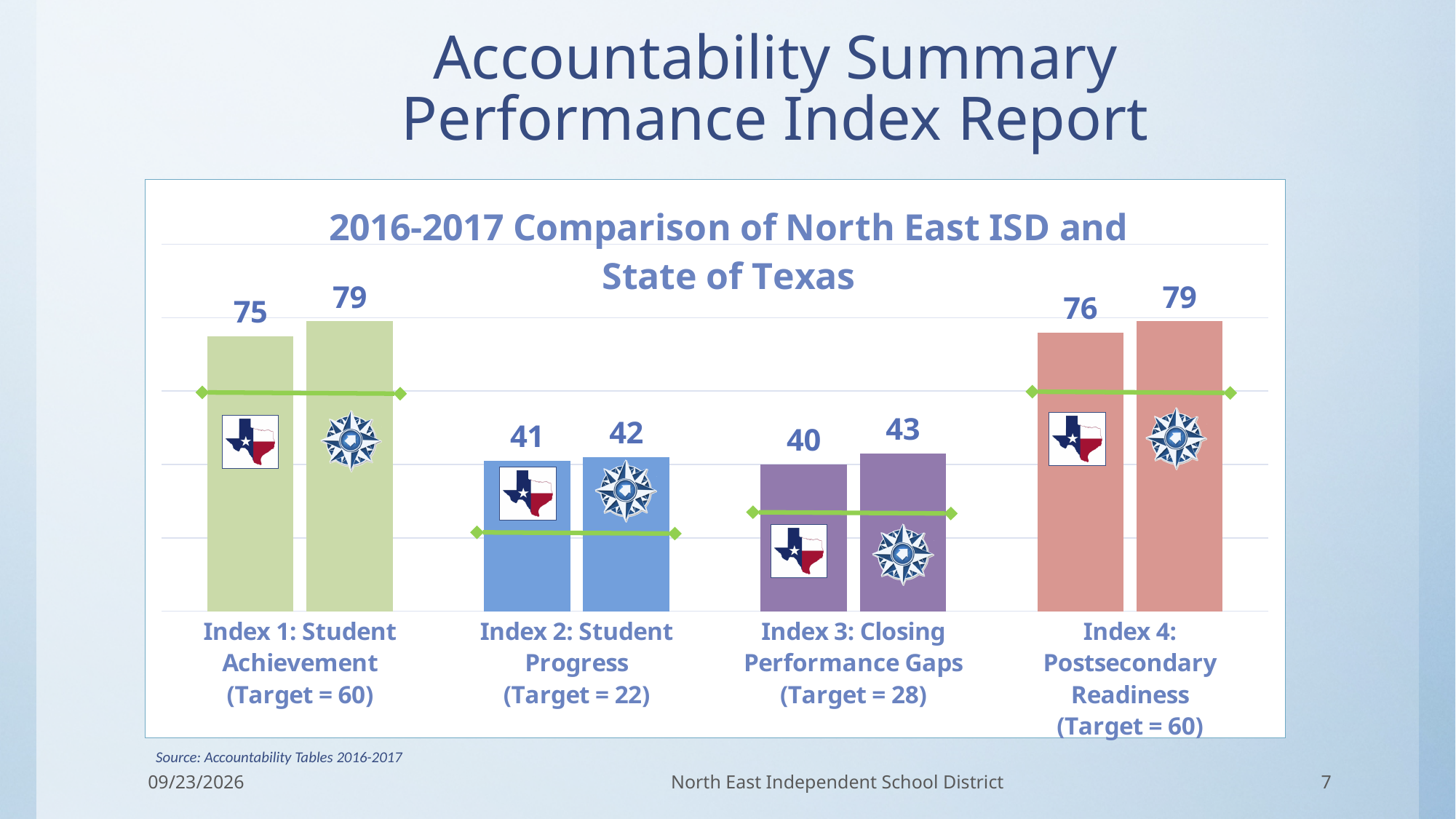
Which index category has the lowest left-bar (Texas icon) value? Index 3: Closing Performance Gaps What is the value of the right bar (compass icon) for Index 3: Closing Performance Gaps? 43 What type of chart is shown on the slide? bar chart What is the difference between the two bars for Index 1: Student Achievement? 4 What is the value of the left bar (Texas icon) for Index 1: Student Achievement? 75 What is the difference between the two bars for Index 3: Closing Performance Gaps? 3 Which is larger: the left bar for Index 2: Student Progress or the left bar for Index 4: Postsecondary Readiness? Index 4: Postsecondary Readiness What is the value of the left bar (Texas icon) for Index 4: Postsecondary Readiness? 76 What is the value of the right bar (compass icon) for Index 1: Student Achievement? 79 How many index categories are shown along the x axis of the chart? 4 What is the target value shown for Index 2: Student Progress? 22 What is the title of the chart? 2016-2017 Comparison of North East ISD and State of Texas